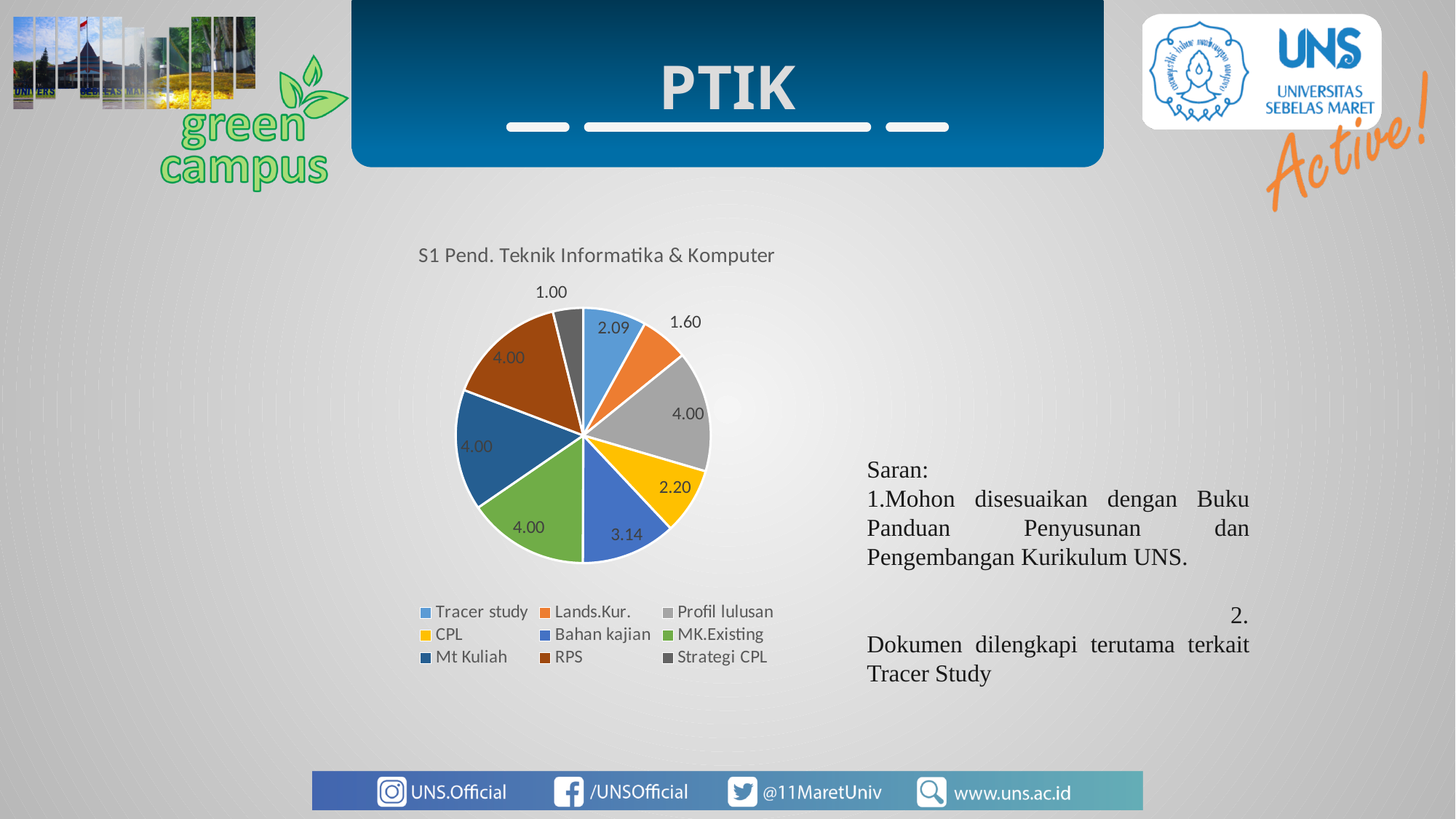
What is the value for Bahan kajian? 3.14 What is the value for CPL? 2.20 What is the value for Lands.Kur.? 1.60 What is the difference between the values for CPL and Lands.Kur.? 0.60 What is the value for Strategi CPL? 1.00 What is the value for Tracer study? 2.09 What is the title of the chart? S1 Pend. Teknik Informatika & Komputer What kind of chart is shown on the slide? pie chart What is the difference between the values for Bahan kajian and Tracer study? 1.05 Which category has the smallest slice? Strategi CPL How many categories does the pie chart have? 9 Which is larger, Bahan kajian or CPL? Bahan kajian